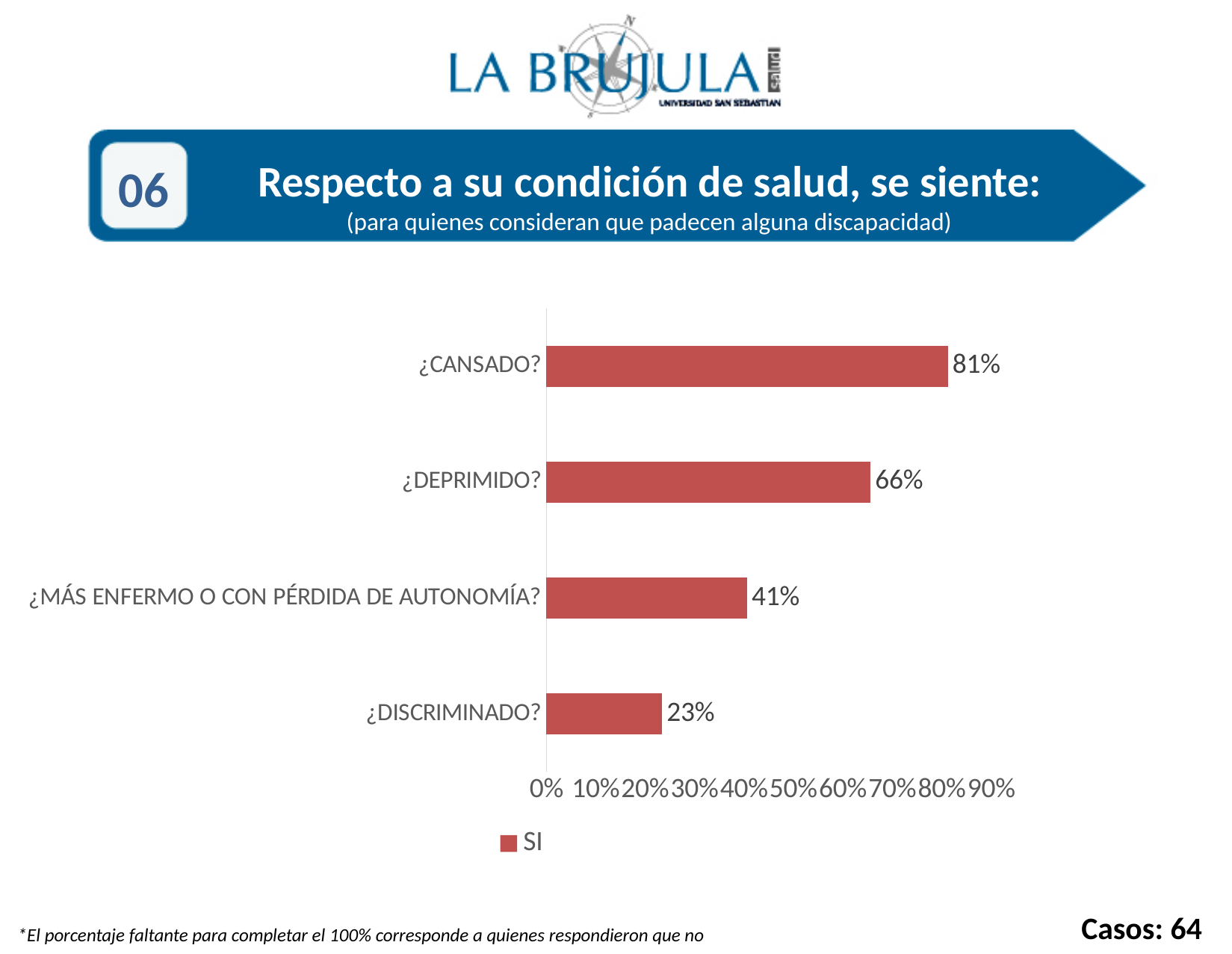
What percentage is shown for ¿MÁS ENFERMO O CON PÉRDIDA DE AUTONOMÍA?? 41% What type of chart is shown on the slide? Bar chart What is the difference between the values for ¿MÁS ENFERMO O CON PÉRDIDA DE AUTONOMÍA? and ¿DISCRIMINADO?? 18% What is the value for ¿DISCRIMINADO?? 23% What percentage of respondents said they feel tired (¿CANSADO?)? 81% What series name does the legend show? SI What is the value shown for ¿DEPRIMIDO?? 66% How many categories are shown in the chart? 4 Which is larger, the value for ¿DEPRIMIDO? or the value for ¿MÁS ENFERMO O CON PÉRDIDA DE AUTONOMÍA?? ¿DEPRIMIDO? Which category has the lowest value? ¿DISCRIMINADO? Which category has the highest value? ¿CANSADO? What is the difference between the values for ¿CANSADO? and ¿DEPRIMIDO?? 15%